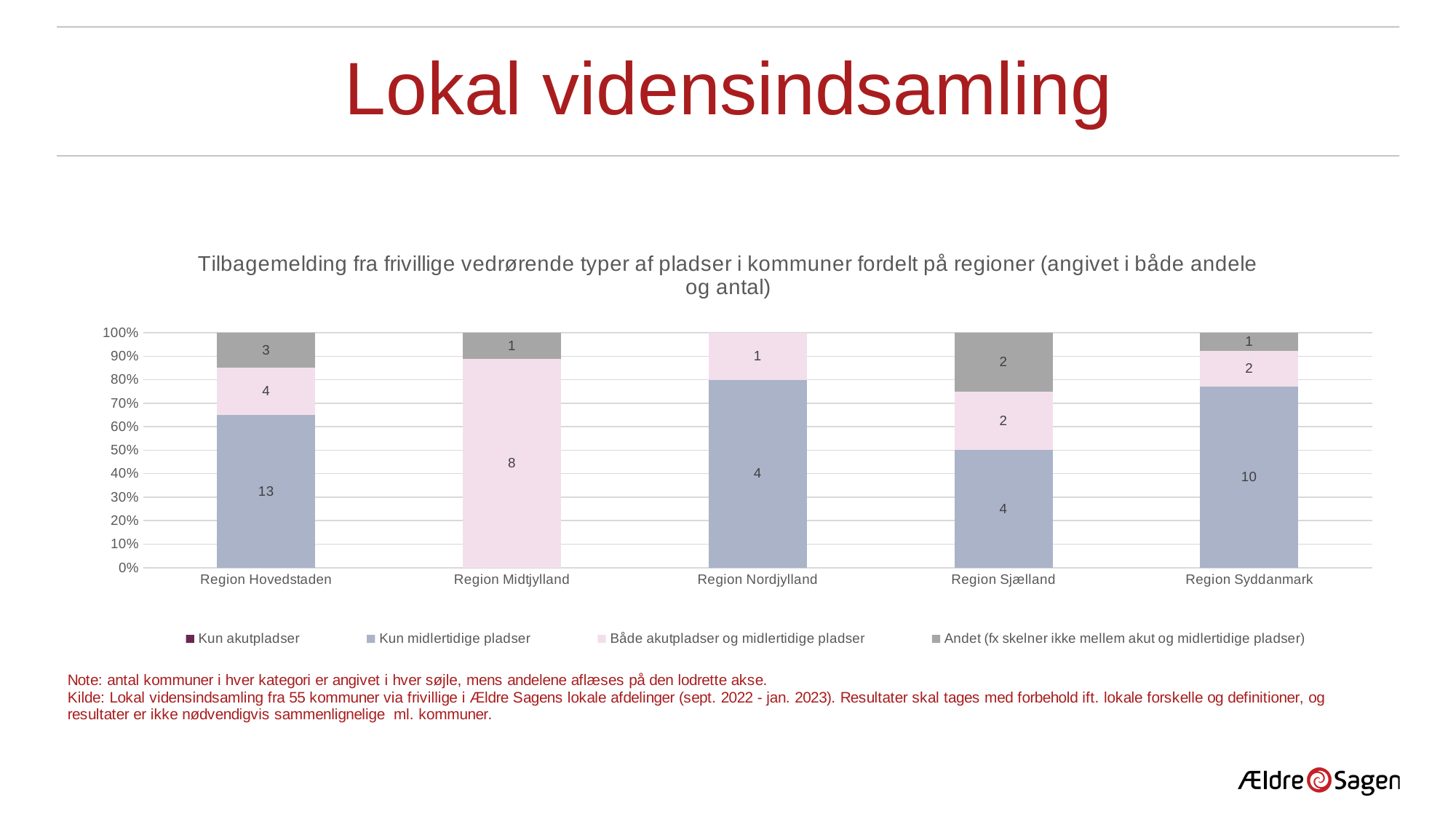
How many municipalities in Region Syddanmark reported 'Kun midlertidige pladser'? 10 How many series does the legend list? 4 What is the number shown for 'Andet' in Region Sjælland? 2 What is the difference between the 'Kun midlertidige pladser' counts for Region Hovedstaden and Region Syddanmark? 3 How many regions are shown on the x axis? 5 Is the share of 'Kun midlertidige pladser' in Region Nordjylland greater or less than 70%? greater What is the number shown for 'Både akutpladser og midlertidige pladser' in Region Midtjylland? 8 Which is larger: the 'Andet' count for Region Hovedstaden or for Region Syddanmark? Region Hovedstaden What is the total number of municipalities counted in the Region Hovedstaden bar? 20 Which region has the highest number of municipalities reporting 'Kun midlertidige pladser'? Region Hovedstaden What kind of chart is shown on the slide? Stacked bar chart How many municipalities in Region Hovedstaden reported 'Kun midlertidige pladser'? 13